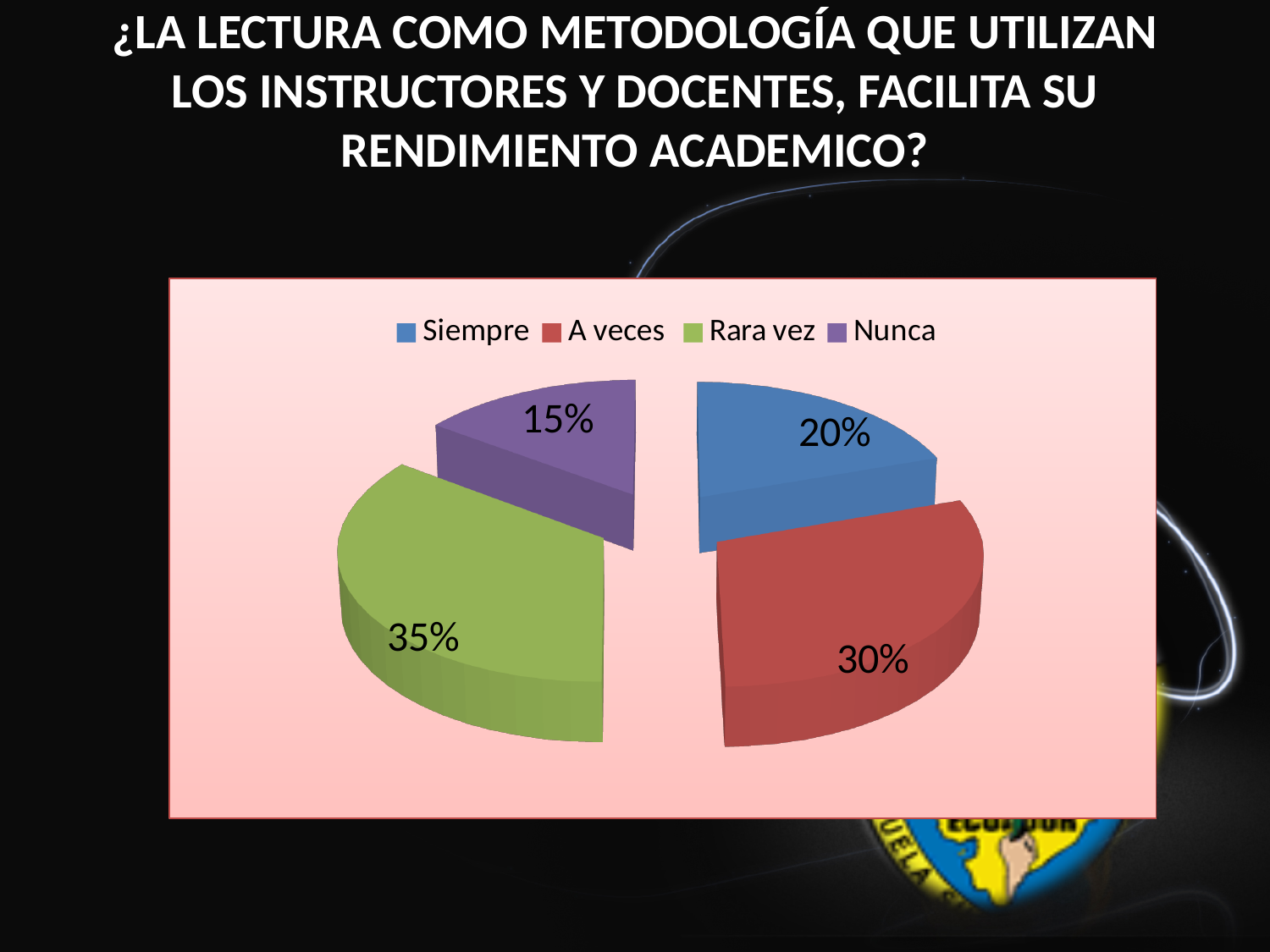
What percentage does the 'Nunca' slice show? 15% What colour is the 'Rara vez' slice? green What percentage does the 'Siempre' slice show? 20% What is the difference in percentage points between 'Rara vez' and 'Nunca'? 20 What percentage does the 'A veces' slice show? 30% How many entries does the legend list? 4 What kind of chart is shown on the slide? pie chart Which is larger, the 'A veces' slice or the 'Siempre' slice? A veces Which category has the largest share of the pie? Rara vez How many slices does the pie chart have? 4 Which category has the smallest share of the pie? Nunca What percentage does the 'Rara vez' slice show? 35%